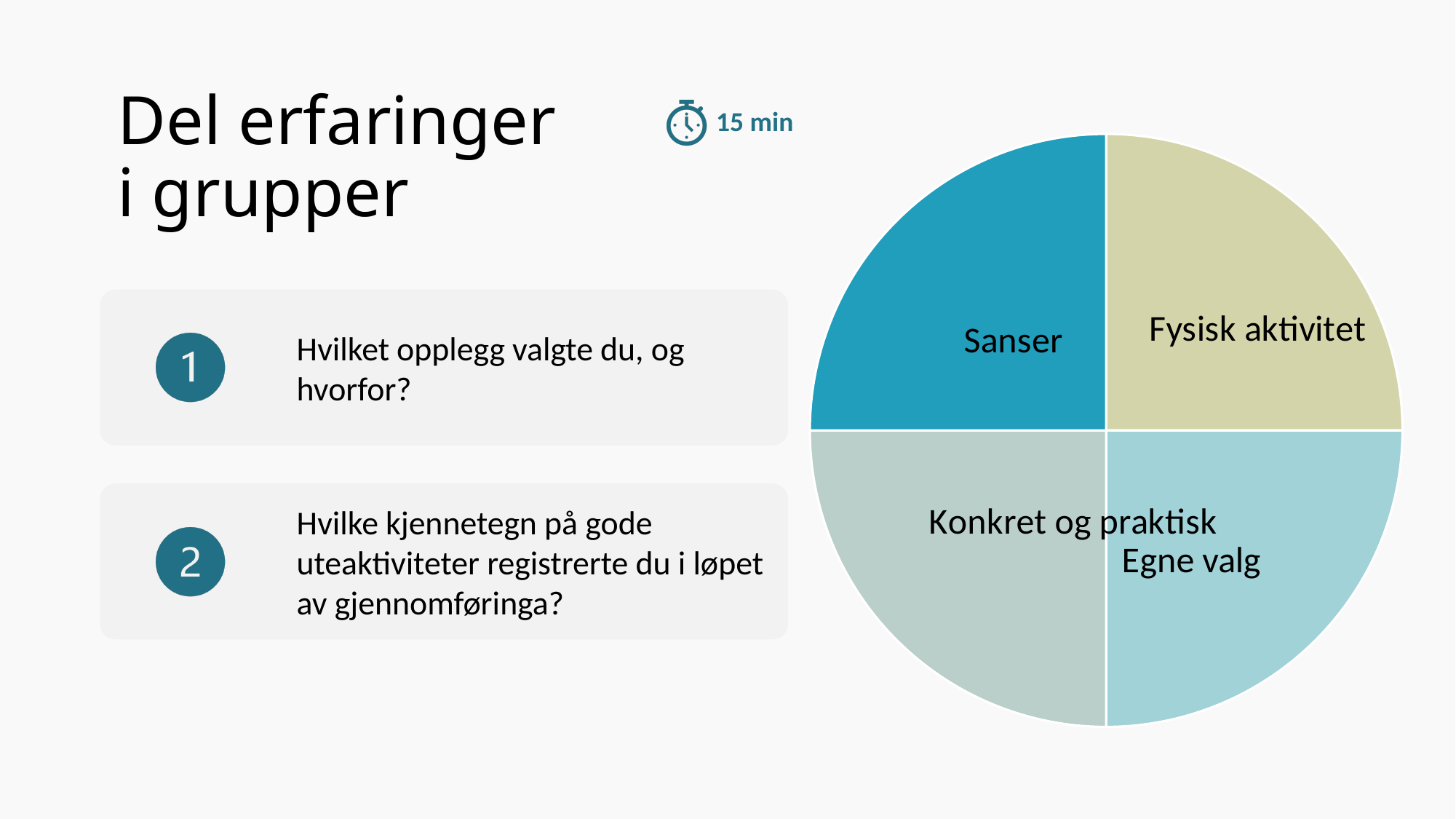
Which slice of the pie chart is in the top-left quarter? Sanser What kind of chart is shown on the right side of the slide? Pie chart Which slice of the pie chart is in the top-right quarter? Fysisk aktivitet Which slice of the pie chart is in the bottom-right quarter? Egne valg Are the four slices of the pie chart equal in size? Yes Which slice of the pie chart is coloured beige/khaki? Fysisk aktivitet How many slices does the pie chart have? 4 Which slice of the pie chart is in the bottom-left quarter? Konkret og praktisk Which slice of the pie chart is coloured dark teal? Sanser